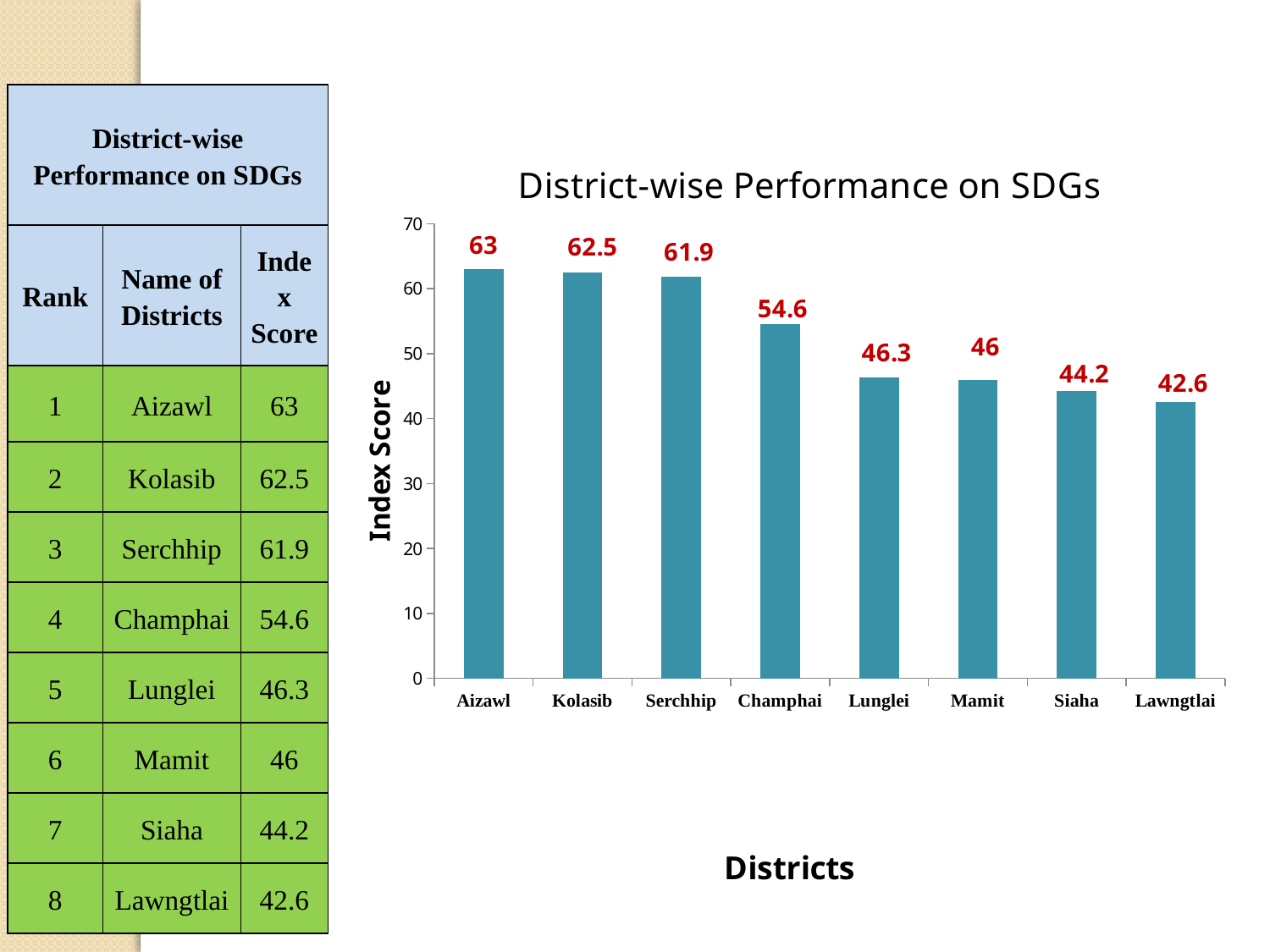
Is the value for Kolasib greater or less than 60? greater What is the difference between the index scores of Aizawl and Lawngtlai? 20.4 What is the index score for Siaha? 44.2 How many districts are shown in the chart? 8 What is the title of the chart? District-wise Performance on SDGs Which district has the highest index score? Aizawl What is the index score for Champhai? 54.6 Do the index scores rise or fall from left to right across the districts? Fall Which has a higher index score, Lunglei or Mamit? Lunglei Which district has the lowest index score? Lawngtlai What type of chart is shown on the slide? Bar chart What is the difference between the index scores of Serchhip and Champhai? 7.3